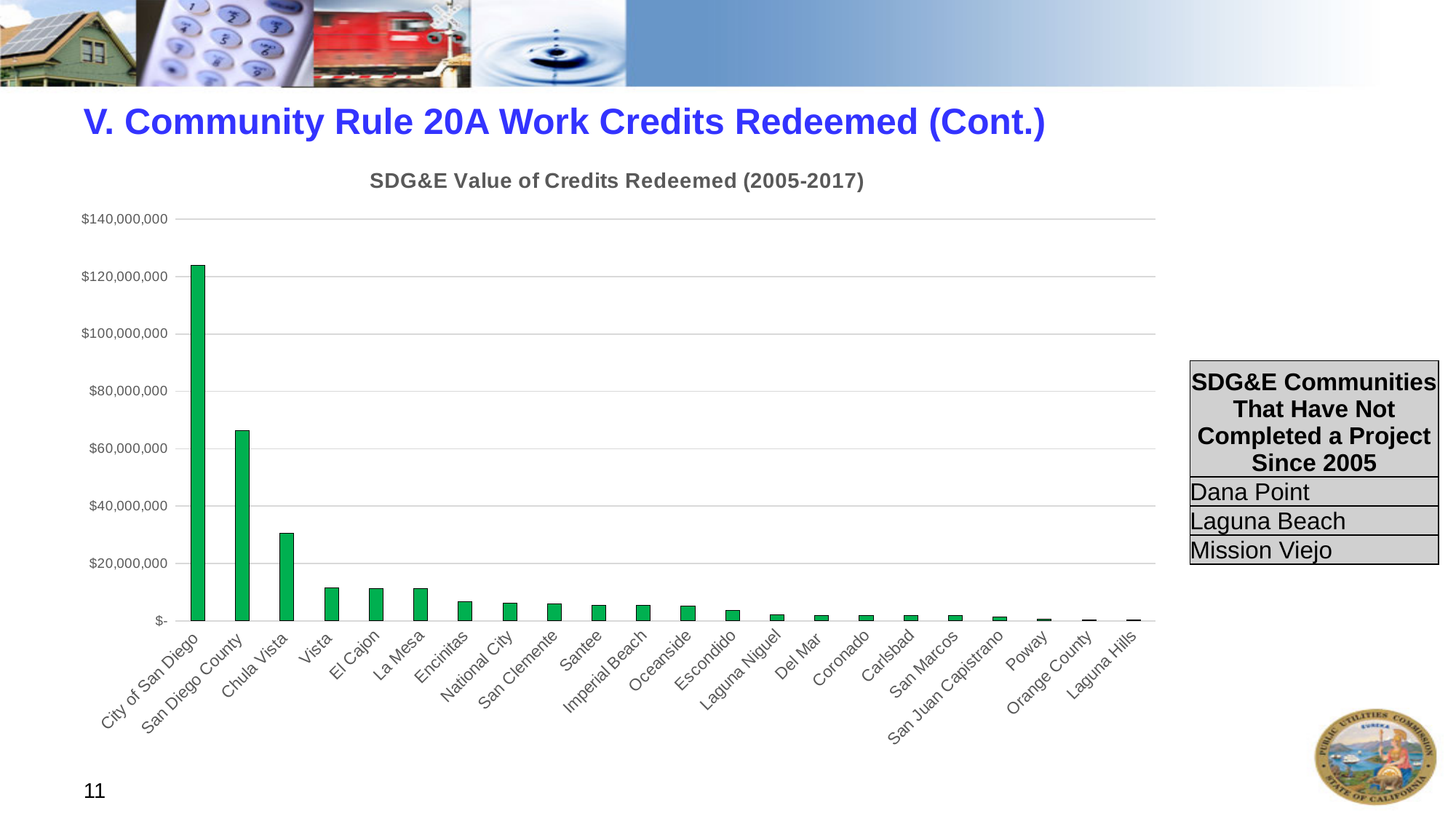
What colour are the bars in the chart? green Which community has the highest value of credits redeemed? City of San Diego Is the value for Encinitas greater or less than $20,000,000? less Do the values rise or fall moving from left to right along the x axis? fall Is the value for Vista greater or less than $20,000,000? less Is the value for San Diego County greater or less than $60,000,000? greater What kind of chart is shown on the slide? bar chart How many communities are plotted on the x axis of the chart? 22 What is the title of the chart? SDG&E Value of Credits Redeemed (2005-2017) Which has a larger value of credits redeemed, San Diego County or Chula Vista? San Diego County